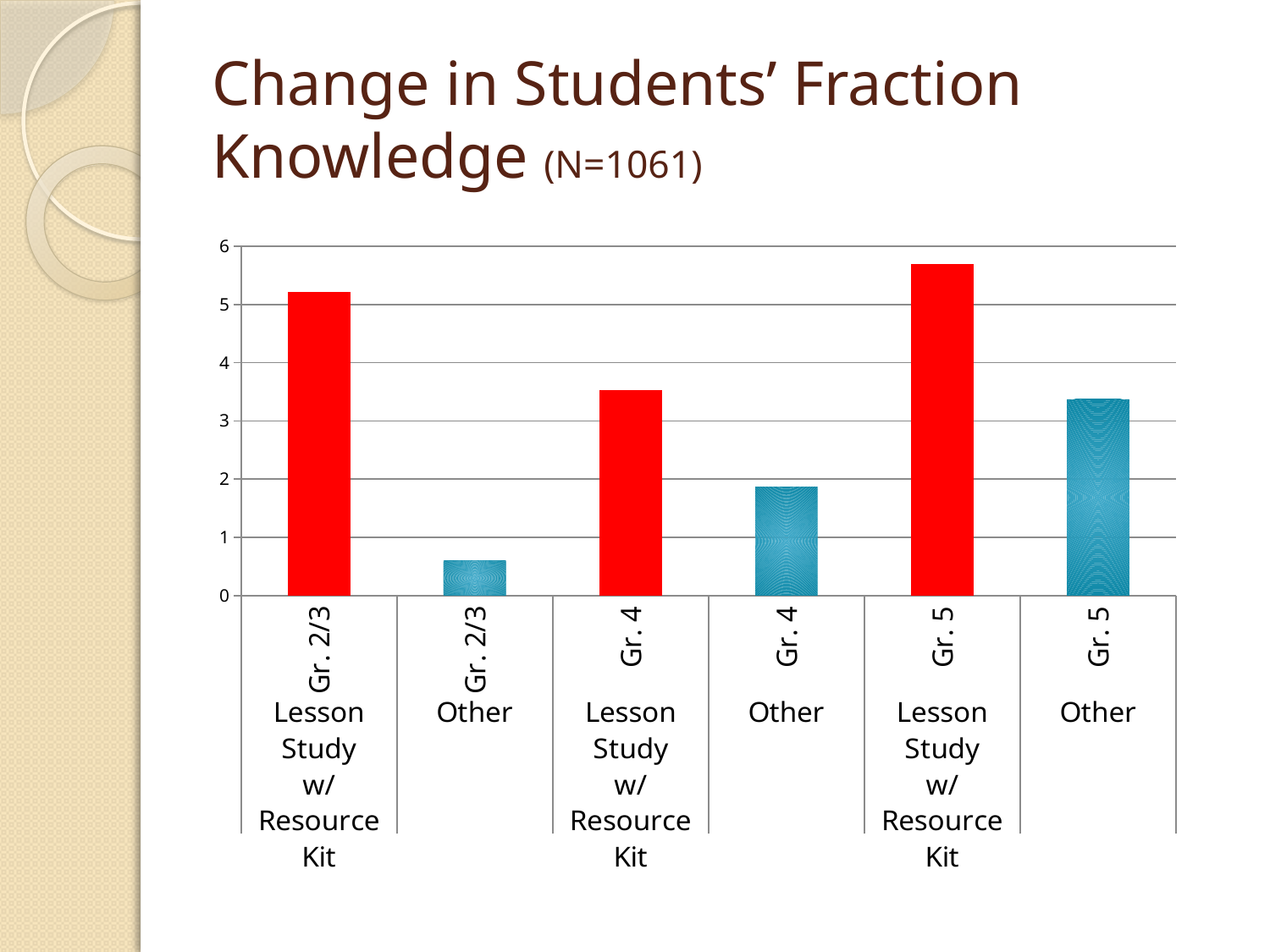
Is the value for Gr. 5 Other greater or less than 3? greater How many bars are plotted in the chart? 6 What kind of chart is shown on the slide? bar chart Is the value for Gr. 2/3 Lesson Study w/ Resource Kit greater or less than 5? greater What is the title of the slide containing the chart? Change in Students' Fraction Knowledge (N=1061) Is the value for Gr. 2/3 Other greater or less than 1? less Which is larger, the value for Gr. 4 Lesson Study w/ Resource Kit or the value for Gr. 4 Other? Gr. 4 Lesson Study w/ Resource Kit Which is larger, the value for Gr. 5 Other or the value for Gr. 2/3 Other? Gr. 5 Other Which bar is the highest in the chart? Gr. 5 Lesson Study w/ Resource Kit Which bar is the lowest in the chart? Gr. 2/3 Other